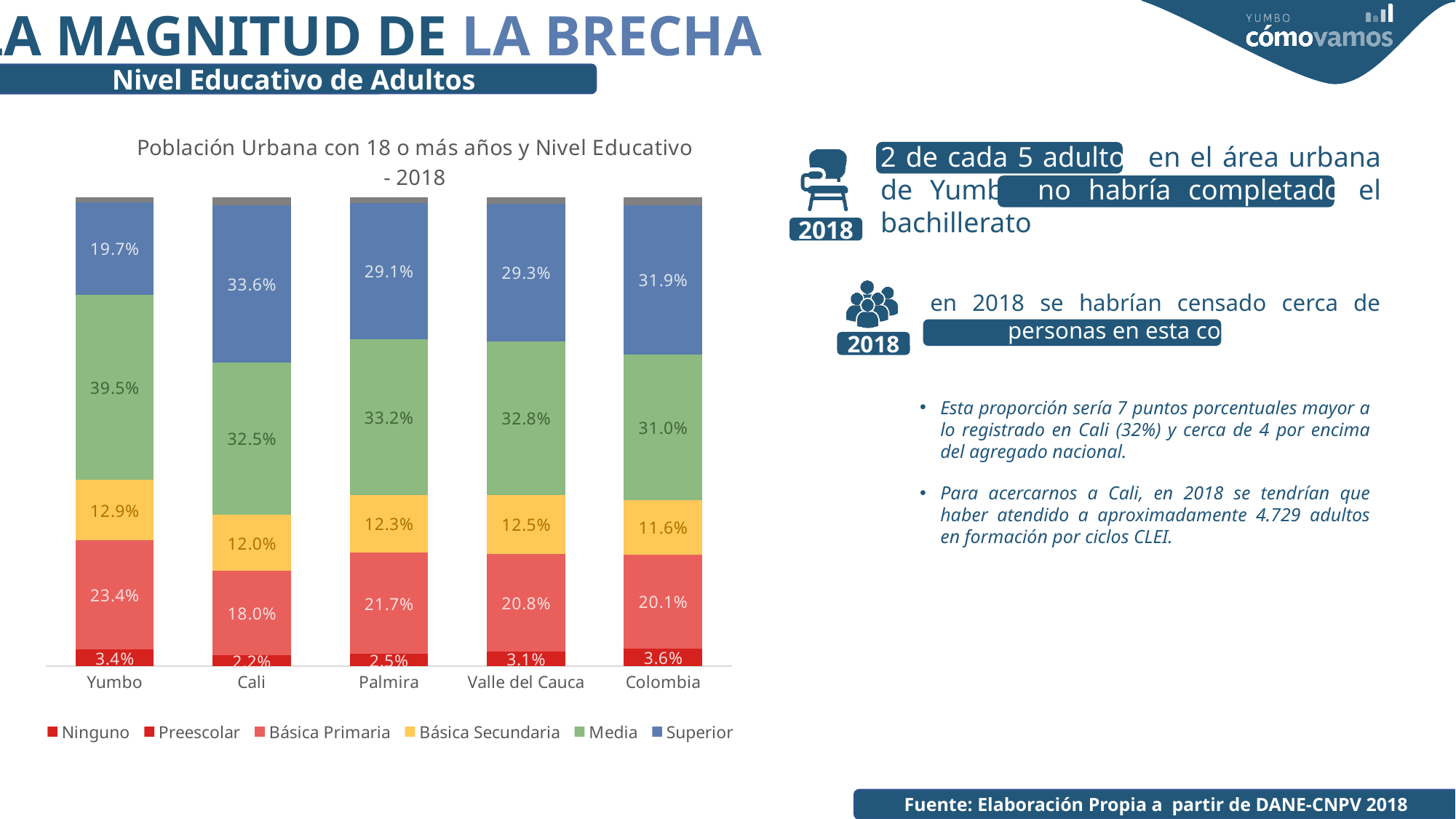
Which category has the lowest Superior share? Yumbo What is the Básica Primaria share for Palmira? 21.7% Which category has the highest Media share? Yumbo What is the Media share for Cali? 32.5% What is the Básica Secundaria share for Colombia? 11.6% What kind of chart is shown? Stacked bar chart How many categories are shown on the x axis? 5 What is the difference between the Superior share for Cali and for Yumbo? 13.9% How many series does the legend list? 6 What is the Superior share for Yumbo? 19.7% Which is larger, the Básica Primaria share for Yumbo or for Cali? Yumbo Which category has the lowest Ninguno share? Cali